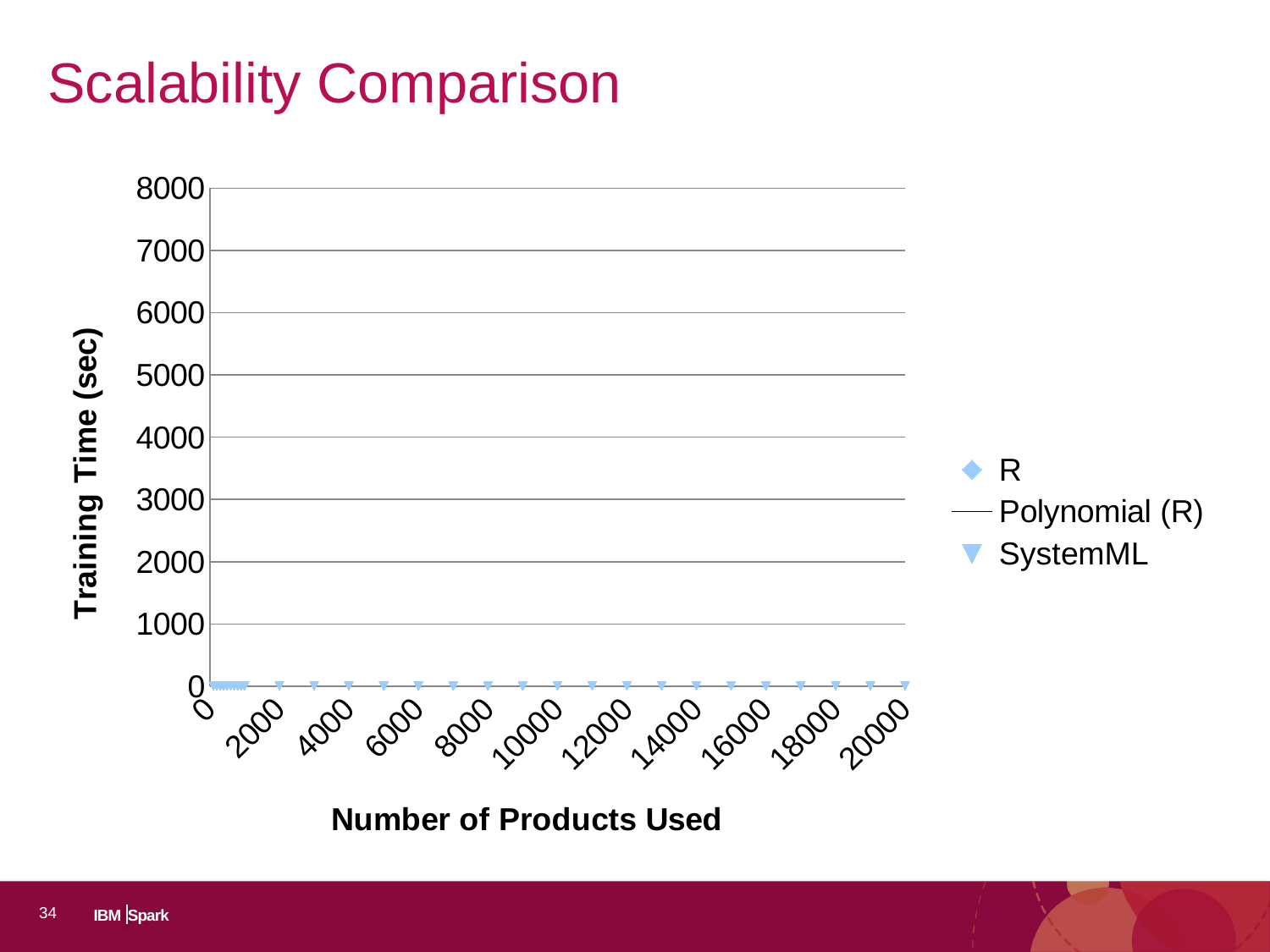
What is the title of the chart? Scalability Comparison Does the SystemML training time rise sharply or stay near zero as the number of products increases? stays near zero Is the SystemML training time at 10000 products greater or less than 1000 seconds? less Which series has points extending to 20000 on the x axis, R or SystemML? SystemML Is the SystemML training time at 20000 products greater or less than 1000 seconds? less How many series does the legend list? 3 What is the highest value shown on the y axis? 8000 What is the label of the y axis? Training Time (sec) What kind of chart is shown on the slide? scatter chart What is the highest value shown on the x axis? 20000